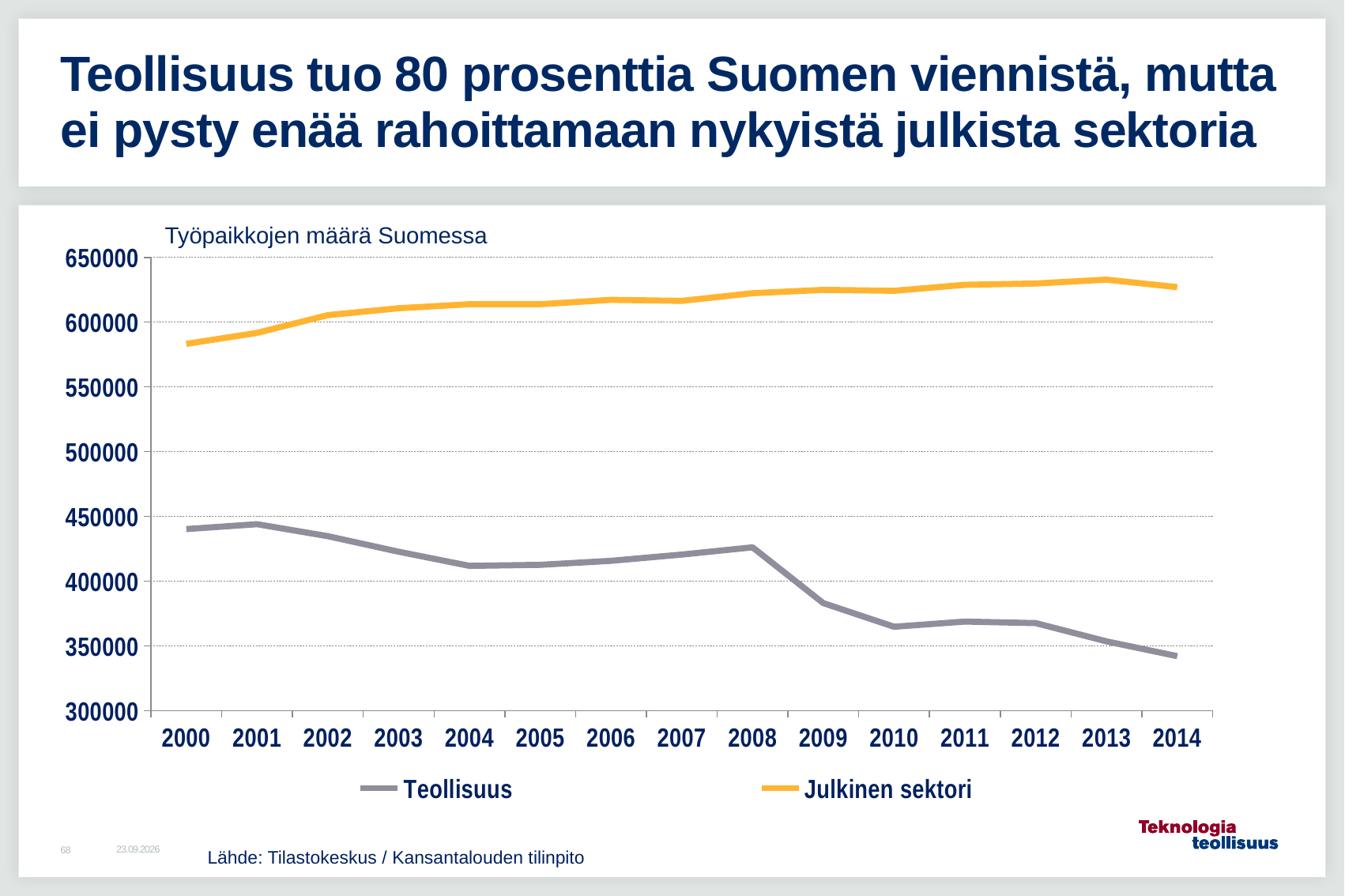
Does the Teollisuus series rise or fall overall from 2000 to 2014? fall In which year is the Teollisuus value lowest? 2014 How many series does the legend list? 2 Is the Julkinen sektori value for 2000 greater or less than 600000? less How many years are shown on the x axis? 15 Is the Teollisuus value for 2009 greater or less than 400000? less Does the Julkinen sektori series rise or fall overall from 2000 to 2014? rise What is the title of the chart? Työpaikkojen määrä Suomessa Is the Teollisuus value for 2014 greater or less than 350000? less What kind of chart is shown on the slide? line chart In which year is the Julkinen sektori value lowest? 2000 Which is larger in 2009: the Teollisuus value or the Teollisuus value in 2008? 2008